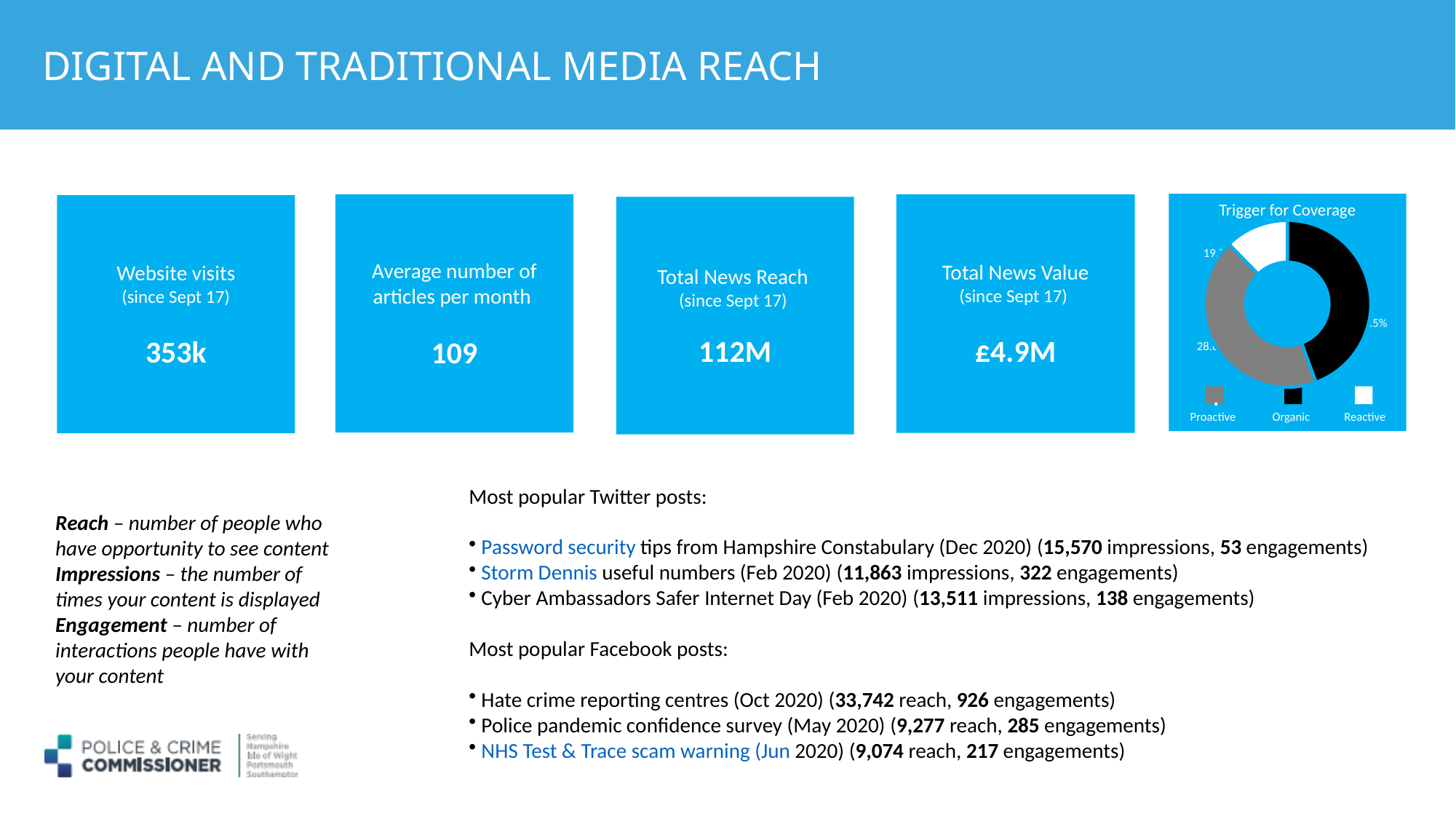
In the "Trigger for Coverage" chart, which is larger: the Proactive share or the Reactive share? Proactive What are the three categories listed in the legend of the "Trigger for Coverage" chart? Proactive, Organic, Reactive What is the title of the chart on the right of the slide? Trigger for Coverage Which category has the smallest share in the "Trigger for Coverage" chart? Reactive Which colour represents Organic in the "Trigger for Coverage" chart? Black In the "Trigger for Coverage" chart, which is larger: the Organic share or the Proactive share? Organic How many categories does the "Trigger for Coverage" chart show? 3 How many entries does the legend of the "Trigger for Coverage" chart list? 3 What type of chart is shown under the title "Trigger for Coverage"? Doughnut chart Which category has the largest share in the "Trigger for Coverage" chart? Organic